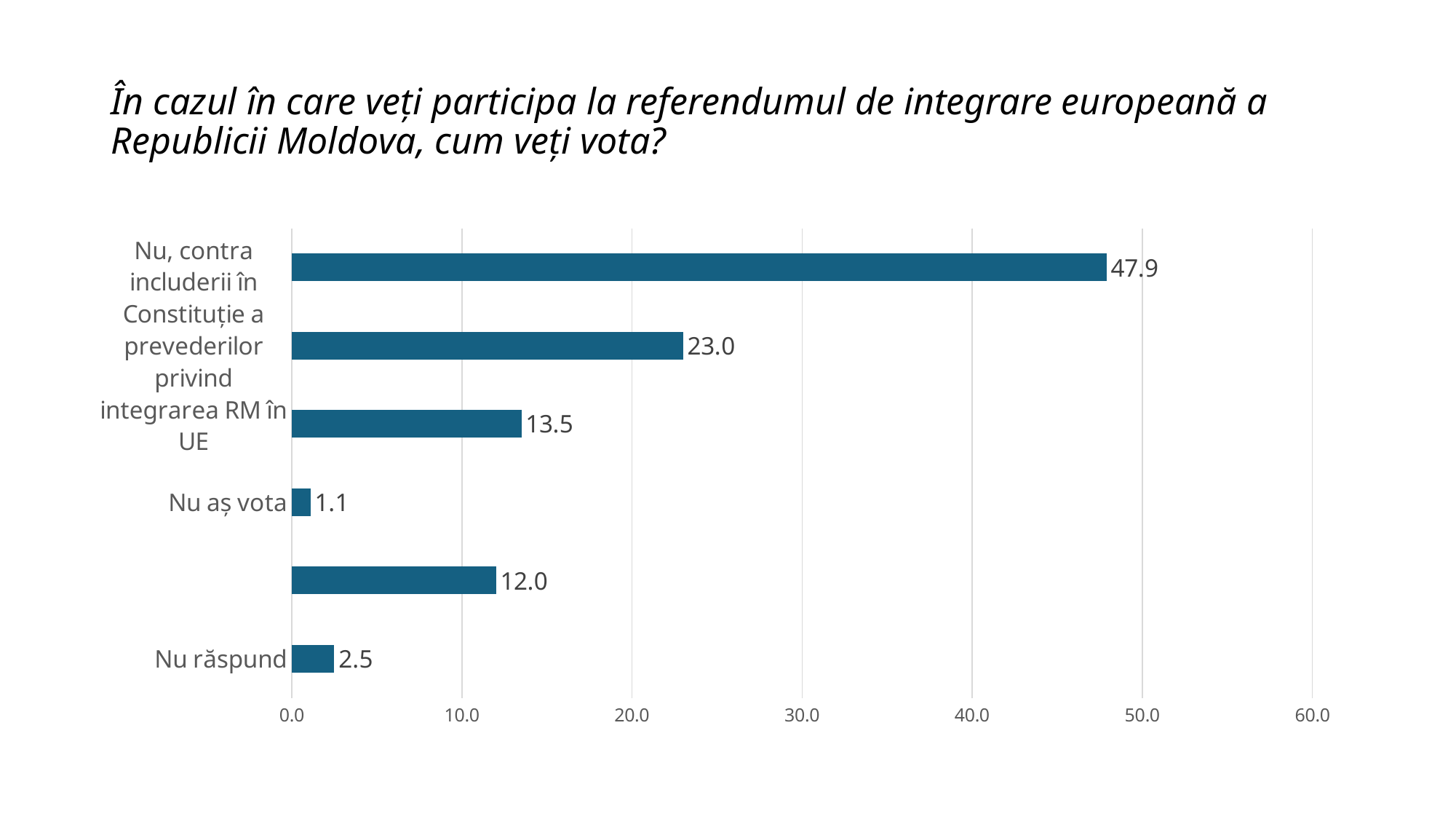
What value is shown for "Nu răspund"? 2.5 What is the value of the second bar from the top? 23.0 What value is shown for "Nu aș vota"? 1.1 How many bars are plotted in the chart? 6 What type of chart is shown on the slide? Bar chart What is the difference between the topmost bar (47.9) and the second bar from the top (23.0)? 24.9 What is the difference between the values for "Nu răspund" and "Nu aș vota"? 1.4 Which category has the lowest value in the chart? Nu aș vota Is the value of the topmost bar greater or less than 40.0? greater Which is larger, the value for "Nu răspund" or the value for "Nu aș vota"? Nu răspund What is the value of the topmost bar in the chart? 47.9 What is the highest value shown in the chart? 47.9